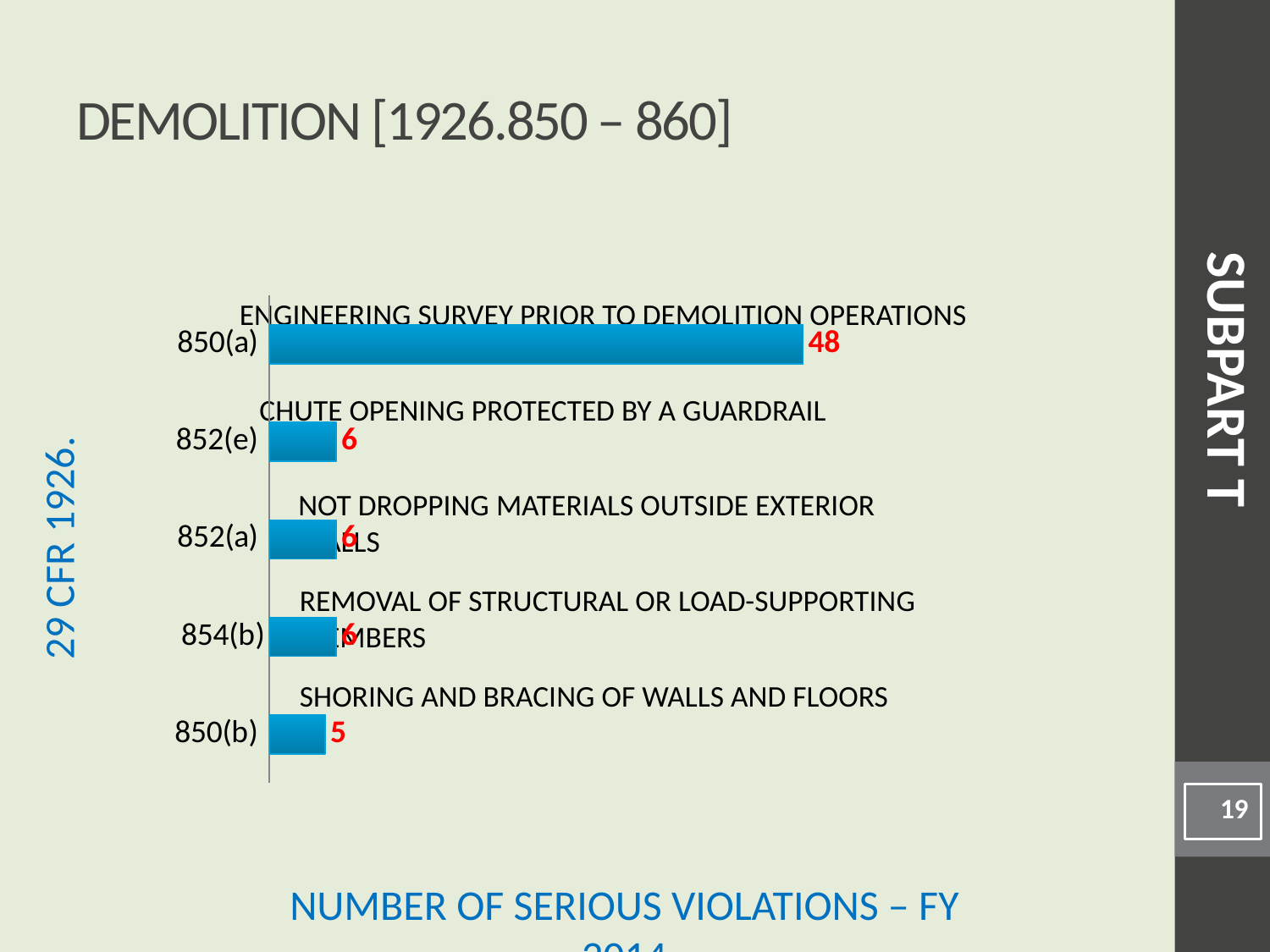
Which category has the highest number of serious violations? 850(a) What is the number of serious violations for 854(b)? 6 What is the number of serious violations for 850(b)? 5 Which category has the lowest number of serious violations? 850(b) What kind of chart is shown on the slide? bar chart What is the difference between the values for 850(a) and 852(e)? 42 Which category is described as 'ENGINEERING SURVEY PRIOR TO DEMOLITION OPERATIONS'? 850(a) Which has a larger value, 850(a) or 850(b)? 850(a) What is the difference between the values for 852(a) and 850(b)? 1 What is the number of serious violations for 850(a)? 48 How many categories are shown in the chart? 5 What is the number of serious violations for 852(e)? 6